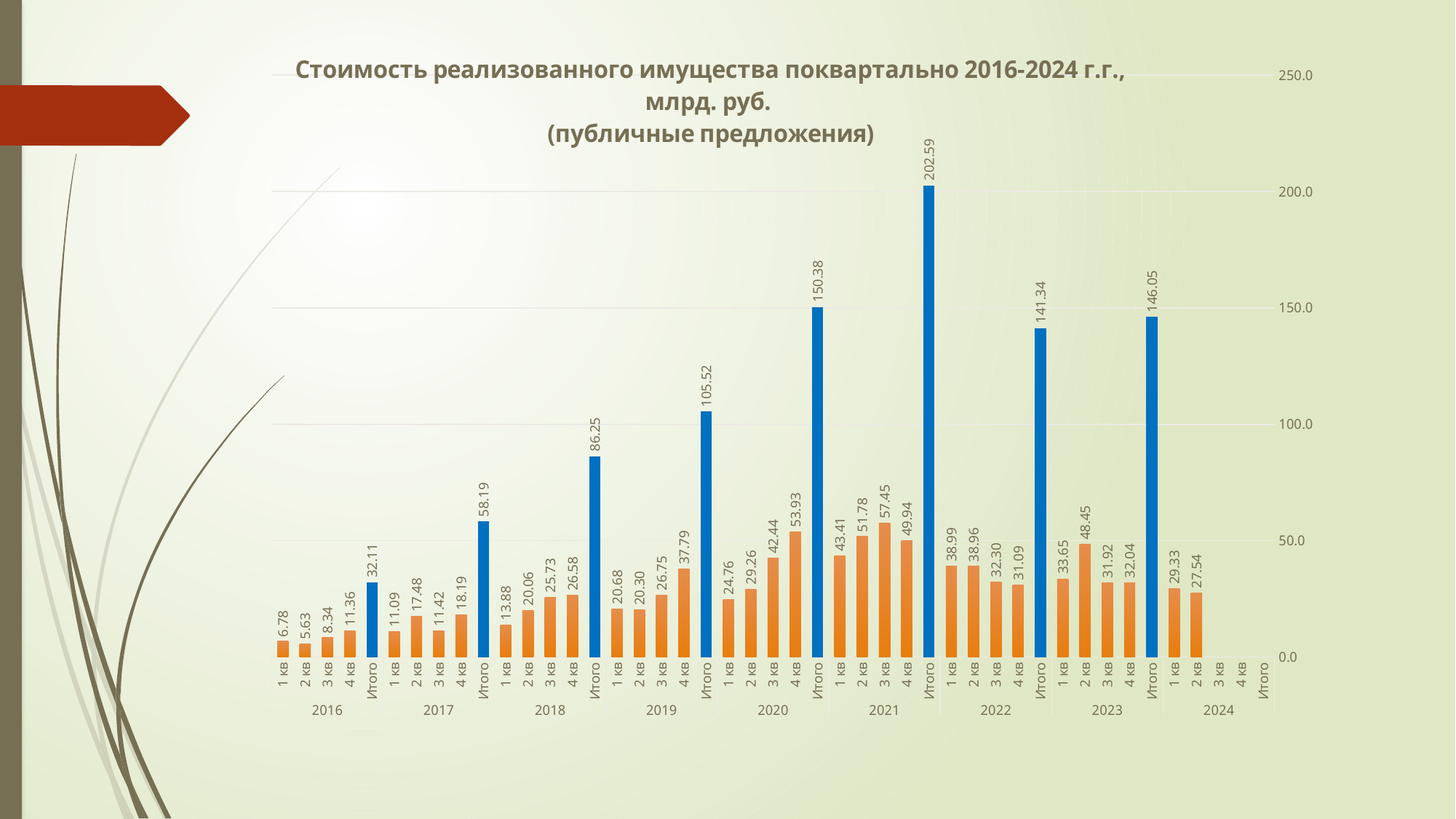
What colour are the Итого (total) bars? Blue Do the Итого values rise or fall from 2016 to 2021? Rise What is the difference between the Итого values for 2021 and 2020? 52.21 How many years are shown along the x axis? 9 Which is larger, the Итого value for 2022 or for 2023? 2023 Which year has the highest Итого (total) bar? 2021 What kind of chart is shown on the slide? Bar chart Which quarter has the lowest value on the chart? 2 кв 2016 What is the value for 4 кв of 2020? 53.93 What is the value of the Итого bar for 2021? 202.59 What is the value for 2 кв of 2024? 27.54 Is the Итого value for 2019 greater or less than 100.0? greater